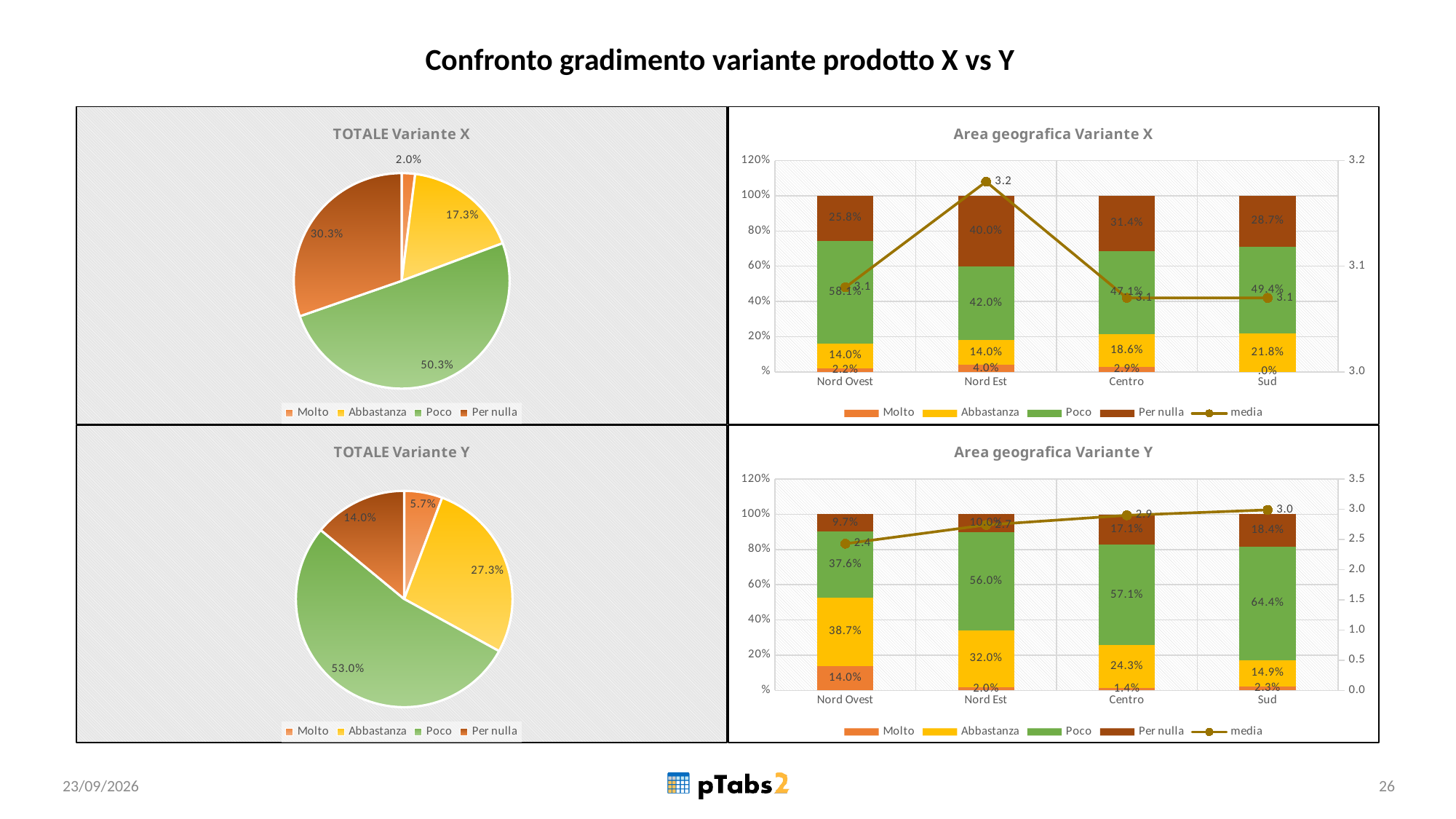
In the Area geografica Variante X chart, which is larger: the Abbastanza value for Sud or for Centro? Sud In the TOTALE Variante X pie chart, what share does the Poco slice have? 50.3% In the Area geografica Variante Y chart, what is the media value for Nord Ovest? 2.4 In the Area geografica Variante Y chart, what is the difference between the Poco values for Sud and Nord Ovest? 26.8% In the Area geografica Variante X chart, which area has the highest media value? Nord Est In the Area geografica Variante X chart, what is the Per nulla value for Nord Est? 40.0% How many series does the legend of the Area geografica Variante X chart list? 5 In the TOTALE Variante Y pie chart, what is the value for Per nulla? 14.0% In the TOTALE Variante Y pie chart, which category has the smallest slice? Molto What kind of chart is TOTALE Variante X? pie chart In the Area geografica Variante Y chart, does the media line rise or fall from Nord Ovest to Sud? rise How many areas are shown on the x axis of the Area geografica Variante Y chart? 4